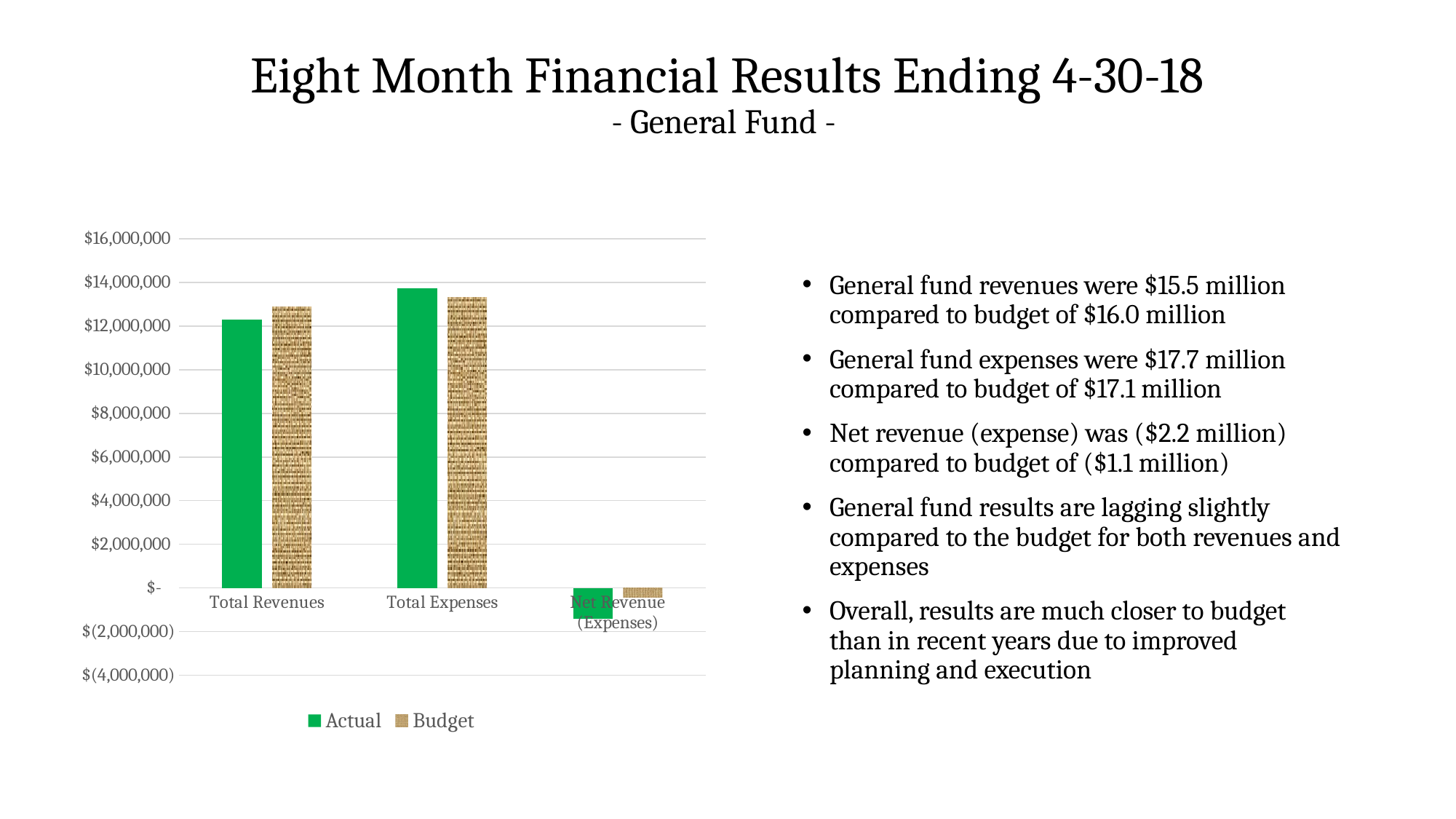
For Total Expenses, which is larger, the Actual bar or the Budget bar? Actual How many series does the chart legend list? 2 Is the Actual value for Net Revenue (Expenses) greater or less than $-? less Which series is shown in green in the chart? Actual Is the Budget value for Total Expenses greater or less than $14,000,000? less Is the Actual value for Total Expenses greater or less than $12,000,000? greater For Total Revenues, which is larger, the Actual bar or the Budget bar? Budget What kind of chart is shown on the slide? Bar chart Which category has the highest Actual value in the chart? Total Expenses How many categories are shown on the x axis of the chart? 3